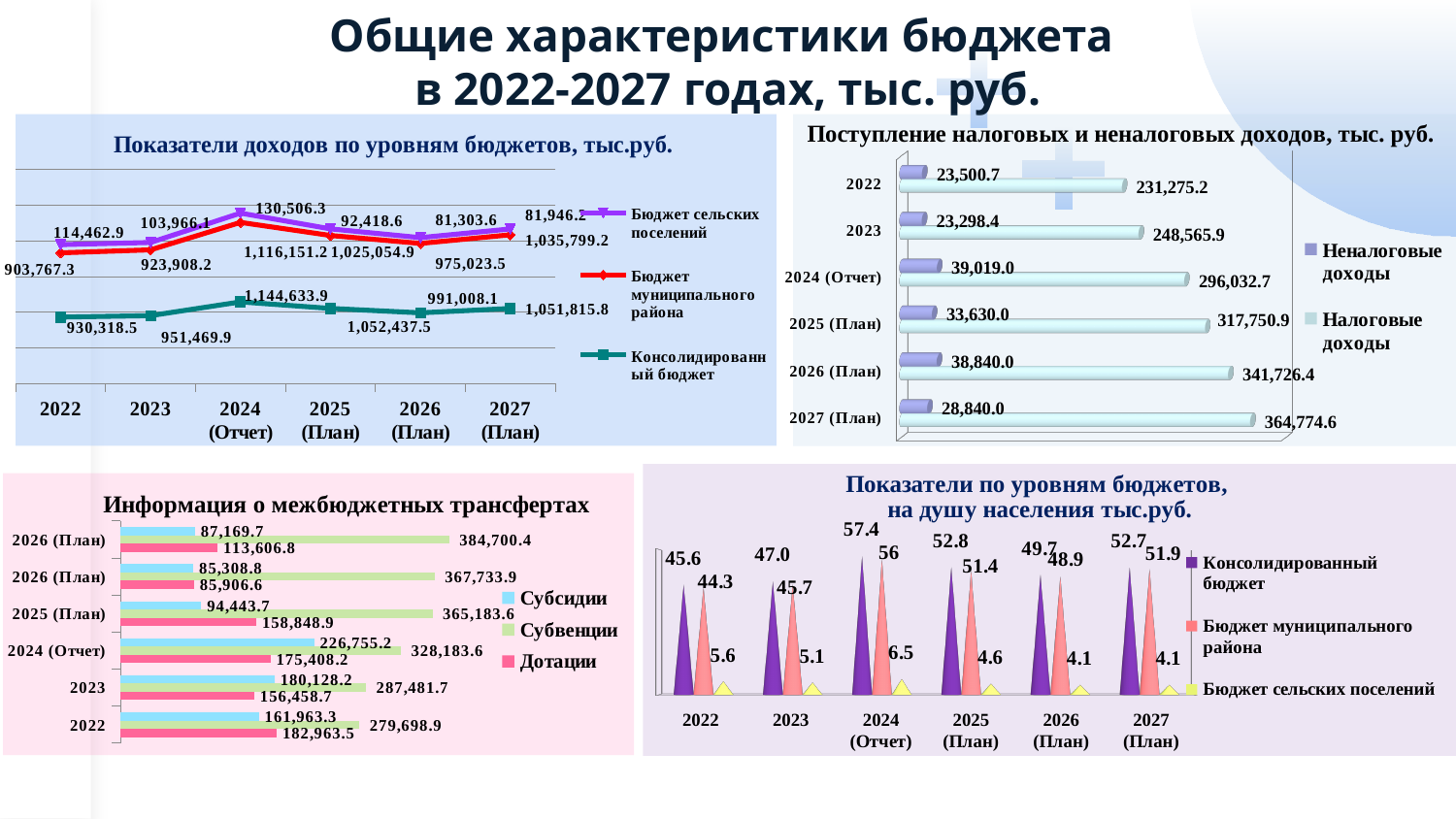
In the chart 'Информация о межбюджетных трансфертах', what is the value of Субвенции for 2024 (Отчет)? 328,183.6 In the chart 'Информация о межбюджетных трансфертах', which is larger for 2022: Субсидии or Дотации? Дотации In the chart 'Показатели доходов по уровням бюджетов, тыс.руб.', what is the value for Бюджет сельских поселений in 2024 (Отчет)? 130,506.3 In the chart 'Показатели доходов по уровням бюджетов, тыс.руб.', in which year is the Консолидированный бюджет highest? 2024 (Отчет) In the chart 'Показатели доходов по уровням бюджетов, тыс.руб.', how many series does the legend list? 3 In the chart 'Поступление налоговых и неналоговых доходов, тыс. руб.', what is the value of Налоговые доходы for 2027 (План)? 364,774.6 In the chart 'Показатели по уровням бюджетов, на душу населения тыс.руб.', how many years are shown on the x axis? 6 In the chart 'Показатели по уровням бюджетов, на душу населения тыс.руб.', what is the value for Бюджет муниципального района in 2024 (Отчет)? 56 In the chart 'Поступление налоговых и неналоговых доходов, тыс. руб.', what is the difference between Налоговые доходы in 2023 and in 2022? 17,290.7 What kind of chart is 'Информация о межбюджетных трансфертах'? bar chart In the chart 'Поступление налоговых и неналоговых доходов, тыс. руб.', in which year are Неналоговые доходы lowest? 2023 In the chart 'Поступление налоговых и неналоговых доходов, тыс. руб.', do Налоговые доходы rise or fall from 2022 to 2027 (План)? rise